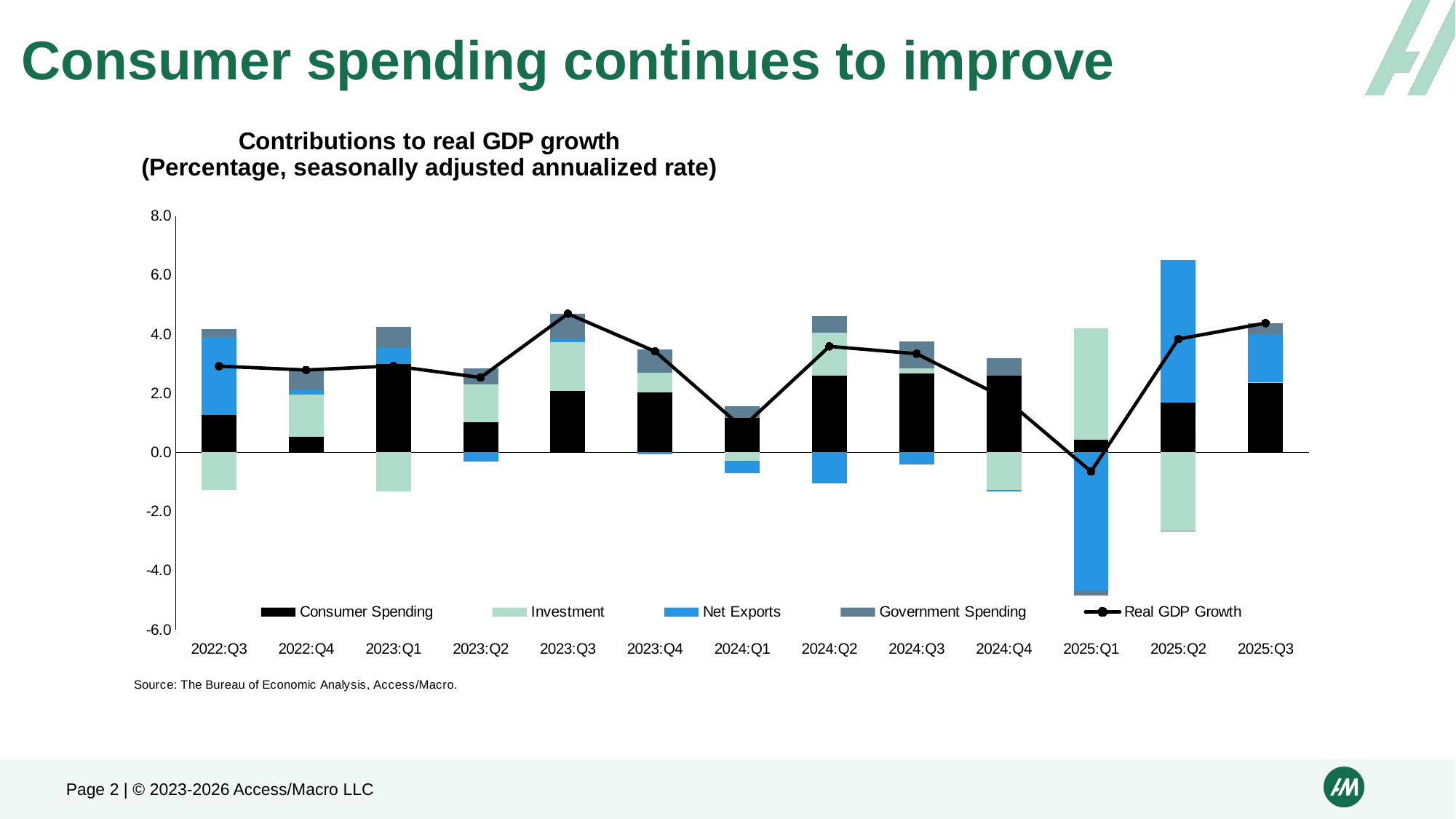
Is Real GDP Growth in 2025:Q1 greater or less than 0.0? less Which is larger, Real GDP Growth in 2023:Q3 or in 2024:Q1? 2023:Q3 In which quarter is the Net Exports contribution most negative? 2025:Q1 What is the title of the chart? Contributions to real GDP growth (Percentage, seasonally adjusted annualized rate) Is the Net Exports contribution in 2025:Q1 greater or less than -4.0? less In which quarter is Real GDP Growth lowest? 2025:Q1 In which quarter is the Investment contribution largest (most positive)? 2025:Q1 In which quarter is the Net Exports contribution largest (most positive)? 2025:Q2 How many series does the legend list? 5 Is Real GDP Growth in 2023:Q3 greater or less than 4.0? greater How many quarters are shown on the x axis? 13 What kind of chart is shown on the slide? A stacked bar chart with a line overlay